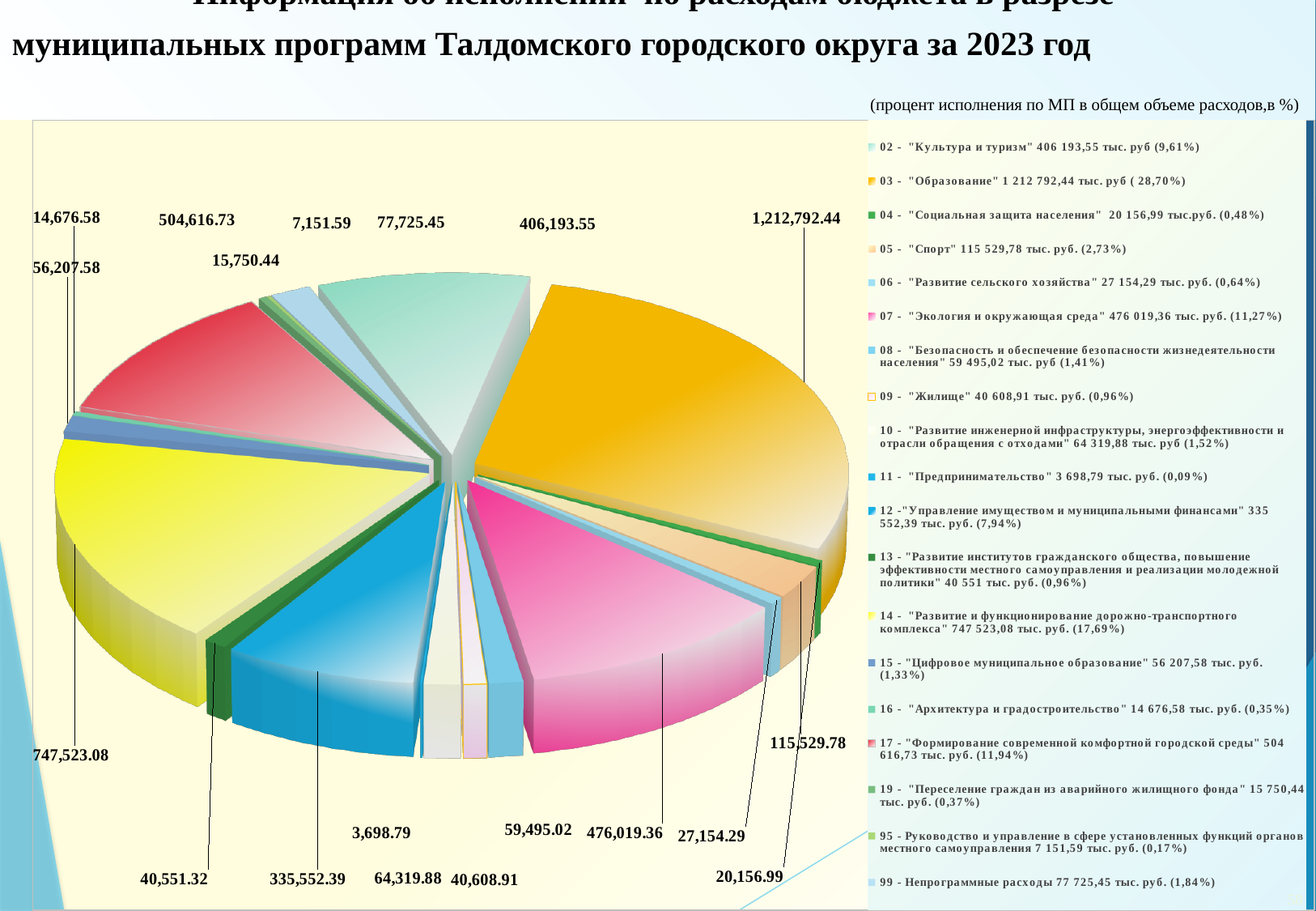
What share of total expenditure does "Экология и окружающая среда" (07) account for, according to the legend? 11,27% Which municipal program has the largest slice of the pie? 03 - "Образование" Which municipal program has the smallest slice of the pie? 11 - "Предпринимательство" How many slices (programs) does the pie chart contain? 19 Which is larger: the value for "Экология и окружающая среда" (07) or for "Формирование современной комфортной городской среды" (17)? "Формирование современной комфортной городской среды" (17) What is the value shown for "Спорт" (05)? 115,529.78 What is the difference between the value for "Образование" (1,212,792.44) and the value for "Развитие и функционирование дорожно-транспортного комплекса" (747,523.08)? 465,269.36 What share of total expenditure does "Образование" (03) account for, according to the legend? 28,70% What is the value shown for "Культура и туризм" (02)? 406,193.55 What is the value shown for "Развитие и функционирование дорожно-транспортного комплекса" (14)? 747,523.08 What kind of chart is shown on the slide? pie chart What is the name of legend entry 99? Непрограммные расходы